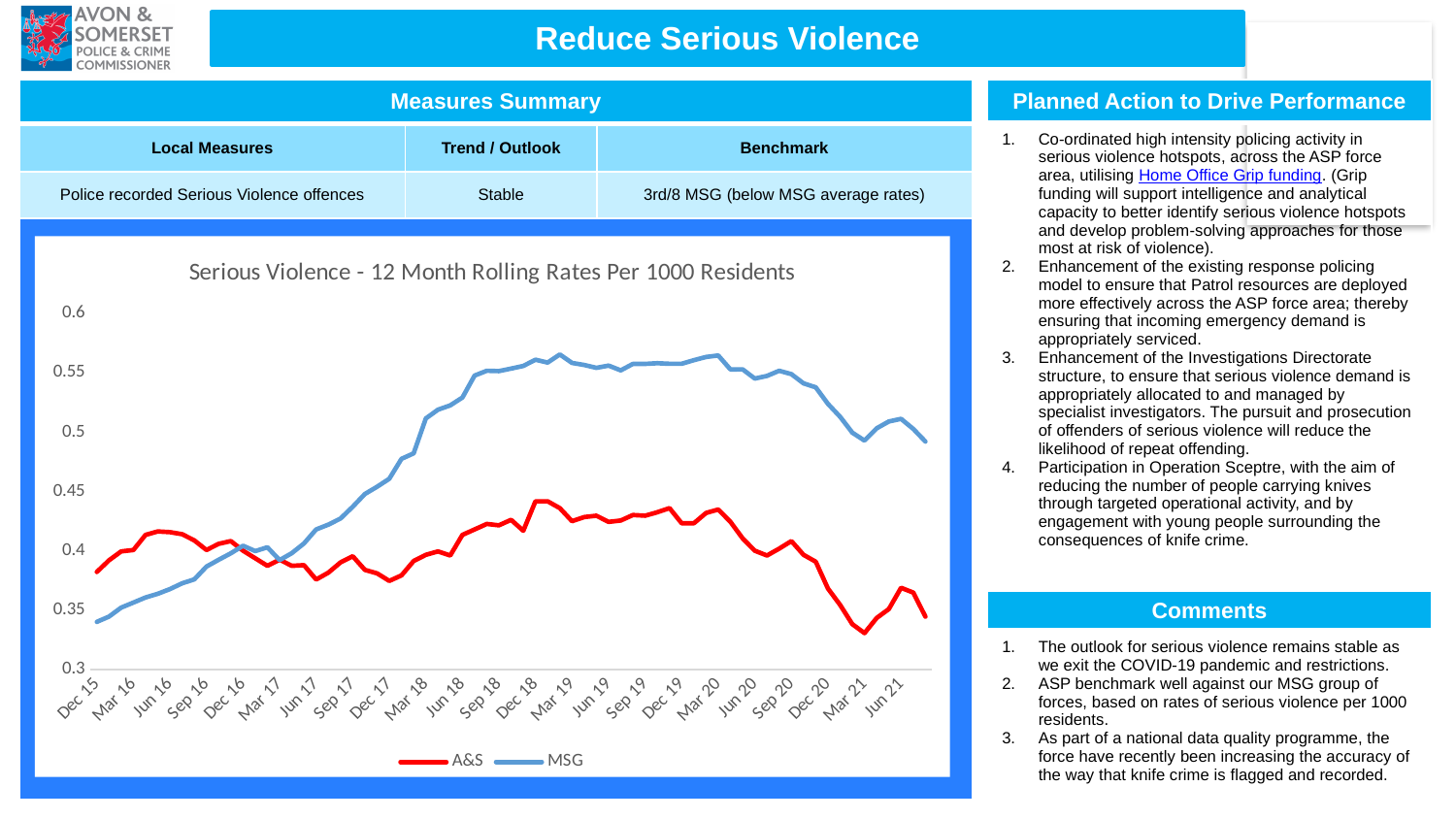
Is the MSG value at Jun 18 greater or less than 0.5? greater Is the A&S value at Mar 21 greater or less than 0.35? less Which colour is used for the A&S series in the chart? Red Does the MSG series generally rise or fall between Dec 15 and Mar 20? Rise At Dec 15, which series has the higher value, A&S or MSG? A&S What is the title of the chart? Serious Violence - 12 Month Rolling Rates Per 1000 Residents What kind of chart is shown on the slide? Line chart Is the MSG value at Mar 20 greater or less than 0.55? greater At Jun 21, which series has the higher value, A&S or MSG? MSG How many series does the chart legend list? 2